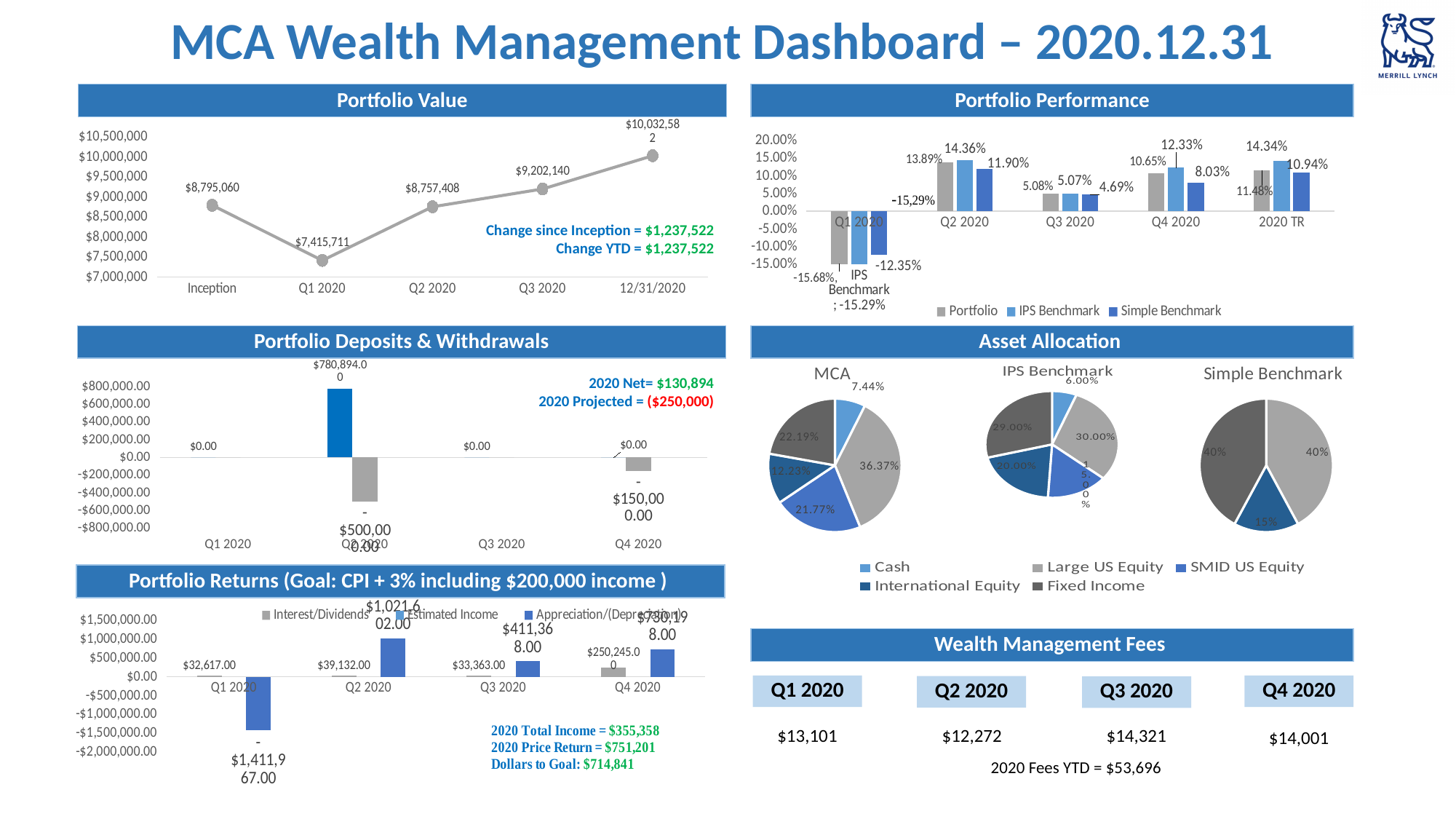
In the Portfolio Deposits & Withdrawals chart, what is the value of the withdrawal bar in Q4 2020? -$150,000.00 In the Portfolio Performance chart, how many series does the legend list? 3 In the Portfolio Value chart, what is the portfolio value at Q3 2020? $9,202,140 In the Portfolio Performance chart, what is the Portfolio return for Q4 2020? 10.65% In the Portfolio Performance chart, what is the Simple Benchmark return for 2020 TR? 10.94% In the Portfolio Performance chart, which is larger for Q2 2020: the IPS Benchmark or the Simple Benchmark? IPS Benchmark In the Portfolio Returns chart, what is the Interest/Dividends value for Q4 2020? $250,245.00 In the Portfolio Value chart, what is the difference between the value at 12/31/2020 and the value at Inception? $1,237,522 In the Asset Allocation MCA pie, what share is Large US Equity? 36.37% In the Asset Allocation IPS Benchmark pie, what share is Fixed Income? 29.00% In the Portfolio Value chart, which point has the lowest portfolio value? Q1 2020 What kind of chart is the Portfolio Value chart? Line chart